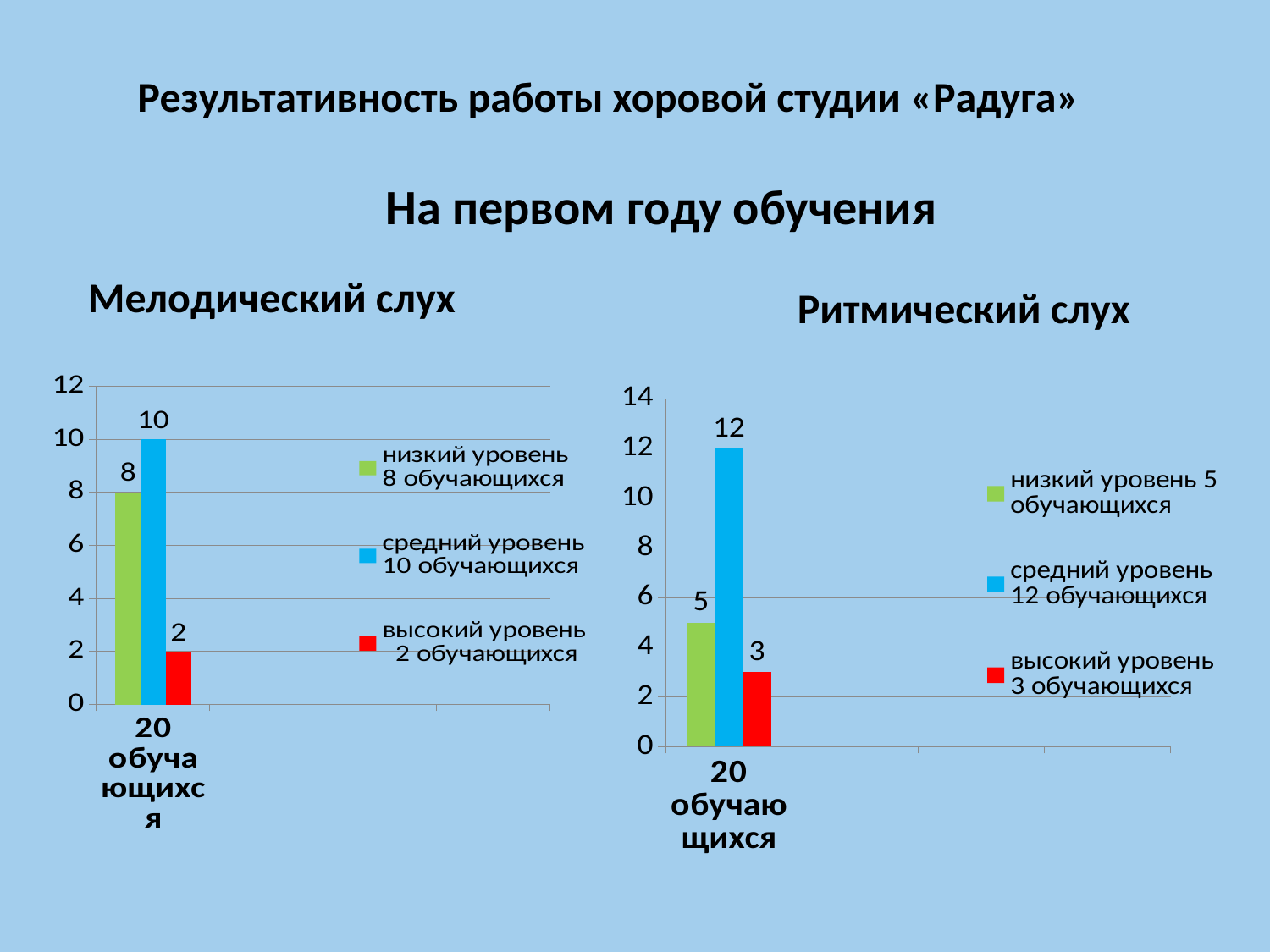
In the "Мелодический слух" chart, what colour is the bar for "средний уровень 10 обучающихся"? blue In the "Мелодический слух" chart, which series has the lowest value? высокий уровень 2 обучающихся In the "Ритмический слух" chart, which series has the highest value? средний уровень 12 обучающихся In the "Ритмический слух" chart, what is the value for "низкий уровень 5 обучающихся"? 5 What kind of chart is the "Ритмический слух" chart? bar chart How many series does the legend of the "Мелодический слух" chart list? 3 In the "Мелодический слух" chart, what is the difference between the values for "средний уровень" and "низкий уровень"? 2 In the "Ритмический слух" chart, what is the difference between the values for "средний уровень" and "высокий уровень"? 9 In the "Ритмический слух" chart, what is the total of the three plotted values? 20 In the "Мелодический слух" chart, what is the value for "высокий уровень 2 обучающихся"? 2 In the "Ритмический слух" chart, which is larger: the value for "низкий уровень" or "высокий уровень"? низкий уровень In the "Мелодический слух" chart, what is the value for "средний уровень 10 обучающихся"? 10